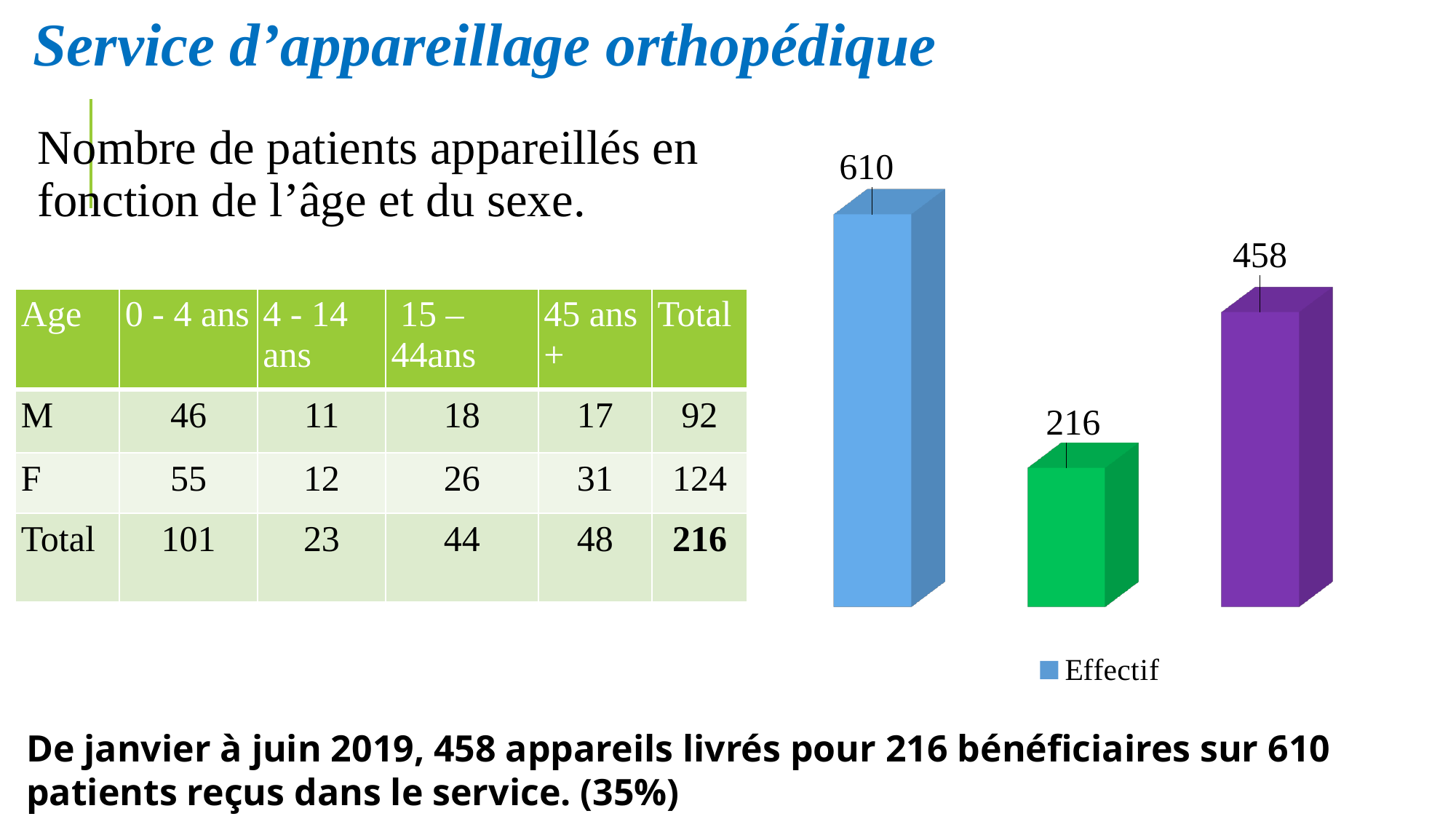
What is the difference between the blue bar (610) and the purple bar (458)? 152 What is the value shown on the green (middle) bar of the chart? 216 Which bar in the chart has the lowest value? the green (middle) bar, 216 Which bar in the chart has the highest value? the blue (first) bar, 610 What is the name of the series shown in the chart legend? Effectif How many bars does the chart show? 3 What kind of chart is shown on the right of the slide? bar chart How many series does the chart legend list? 1 What is the value shown on the blue (first) bar of the chart? 610 What is the difference between the blue bar (610) and the green bar (216)? 394 What is the value shown on the purple (third) bar of the chart? 458 Which is larger in the chart, the purple bar or the green bar? the purple bar